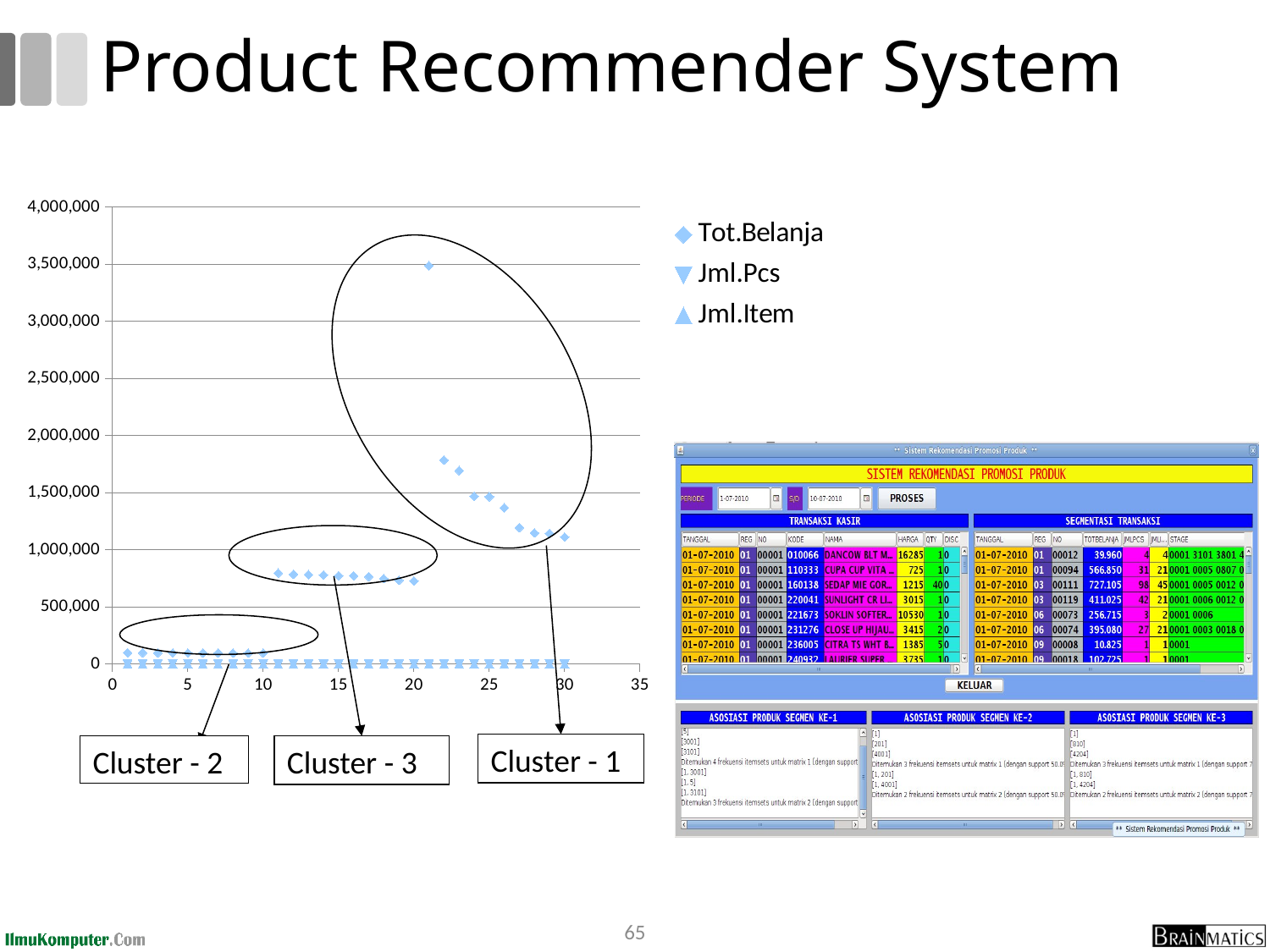
Do the Tot.Belanja values generally rise or fall as the x-axis value increases? rise What kind of chart is shown on the slide? scatter chart What are the three series named in the chart legend? Tot.Belanja, Jml.Pcs, Jml.Item Are the Tot.Belanja points inside Cluster - 3 greater or less than 500,000? greater Is the highest Tot.Belanja point on the chart greater or less than 3,000,000? greater What is the highest value shown on the chart's vertical axis? 4,000,000 Are the Tot.Belanja points inside Cluster - 2 greater or less than 500,000? less How many clusters are labelled on the chart? 3 How many series does the chart legend list? 3 What is the highest value shown on the chart's horizontal axis? 35 Which series has the highest plotted values on the chart? Tot.Belanja